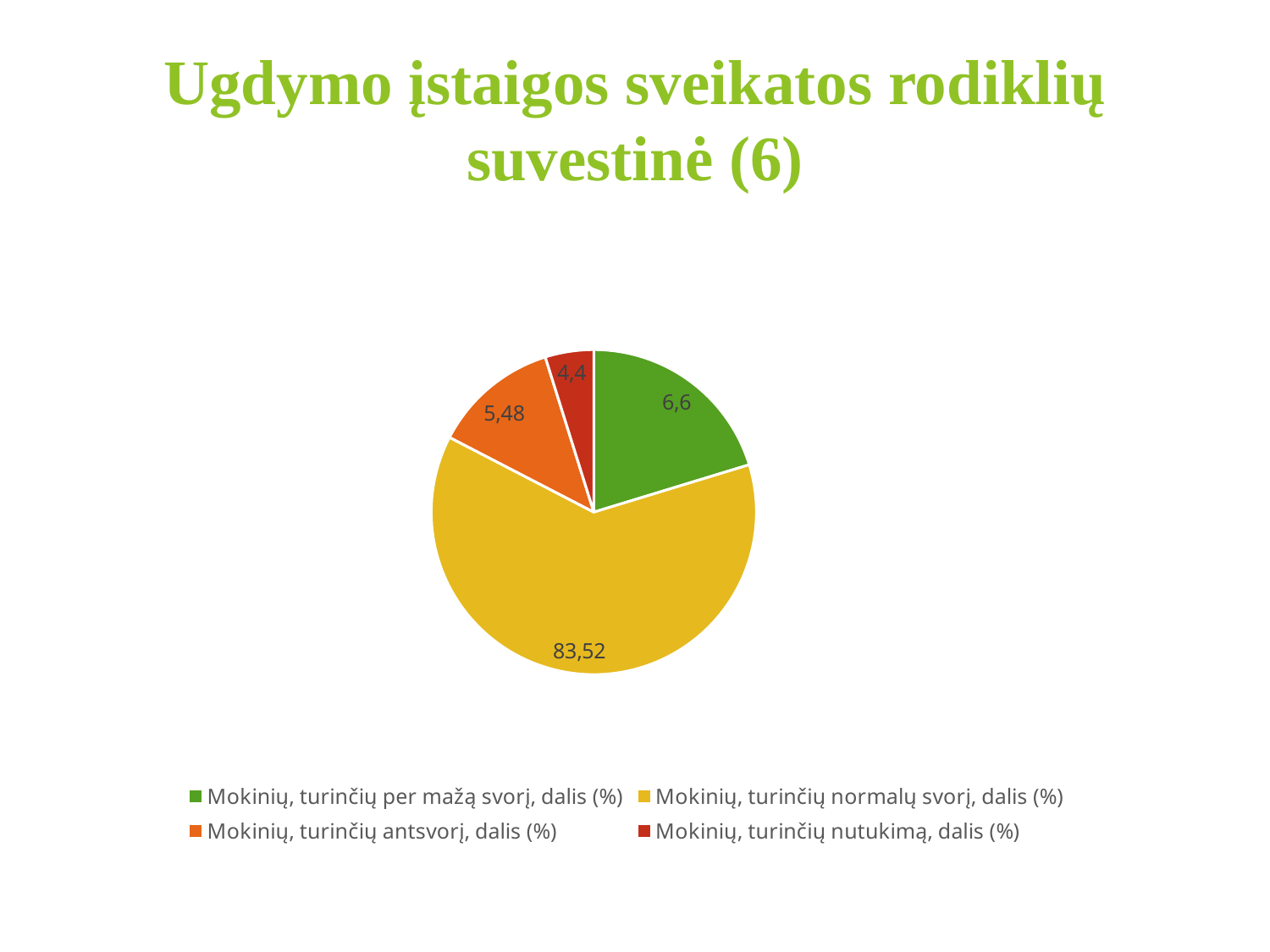
What kind of chart is shown on the slide? Pie chart What value is shown for the slice 'Mokinių, turinčių normalų svorį, dalis (%)'? 83,52 What value is shown for the slice 'Mokinių, turinčių antsvorį, dalis (%)'? 5,48 How many entries does the legend list? 4 What is the difference between the value for 'Mokinių, turinčių normalų svorį, dalis (%)' and the value for 'Mokinių, turinčių per mažą svorį, dalis (%)'? 76,92 What value is shown for the slice 'Mokinių, turinčių nutukimą, dalis (%)'? 4,4 Which category has the largest slice of the pie? Mokinių, turinčių normalų svorį, dalis (%) What colour is the slice for 'Mokinių, turinčių nutukimą, dalis (%)'? Red What value is shown for the slice 'Mokinių, turinčių per mažą svorį, dalis (%)'? 6,6 Which category has the smallest slice of the pie? Mokinių, turinčių nutukimą, dalis (%) Which is larger: the value for 'Mokinių, turinčių per mažą svorį, dalis (%)' or the value for 'Mokinių, turinčių antsvorį, dalis (%)'? Mokinių, turinčių per mažą svorį, dalis (%) How many slices does the pie chart have? 4